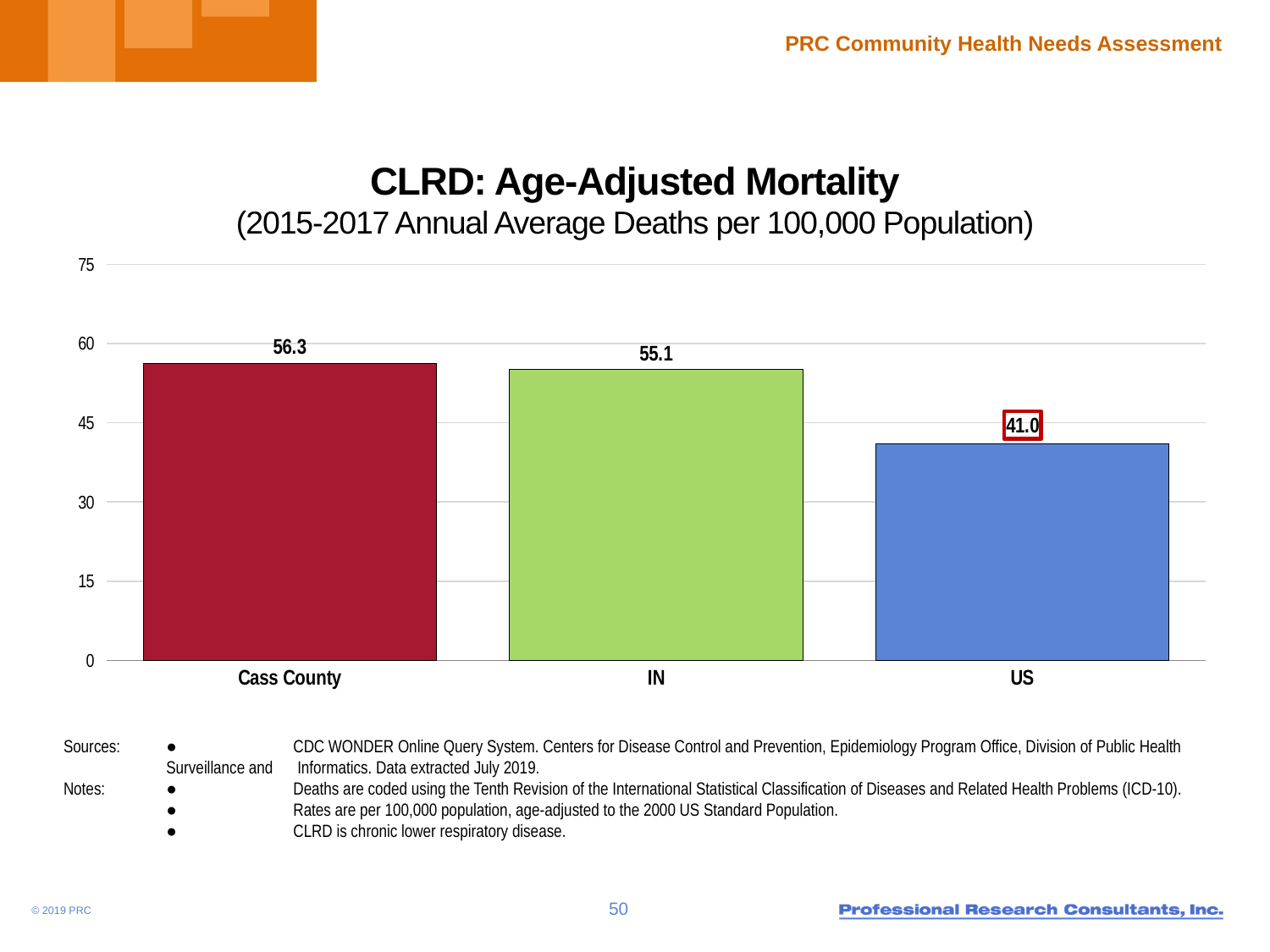
Which has a higher CLRD mortality rate, IN or the US? IN What is the title of the chart? CLRD: Age-Adjusted Mortality What is the CLRD age-adjusted mortality rate for Cass County? 56.3 Is the value for the US greater or less than 45? less What is the CLRD age-adjusted mortality rate for IN? 55.1 How many categories are shown in the chart? 3 What is the difference between the Cass County and US CLRD mortality rates? 15.3 What is the CLRD age-adjusted mortality rate for the US? 41.0 What kind of chart is shown on the slide? Bar chart What is the difference between the Cass County and IN CLRD mortality rates? 1.2 Which category has the highest CLRD age-adjusted mortality rate? Cass County Which category has the lowest CLRD age-adjusted mortality rate? US